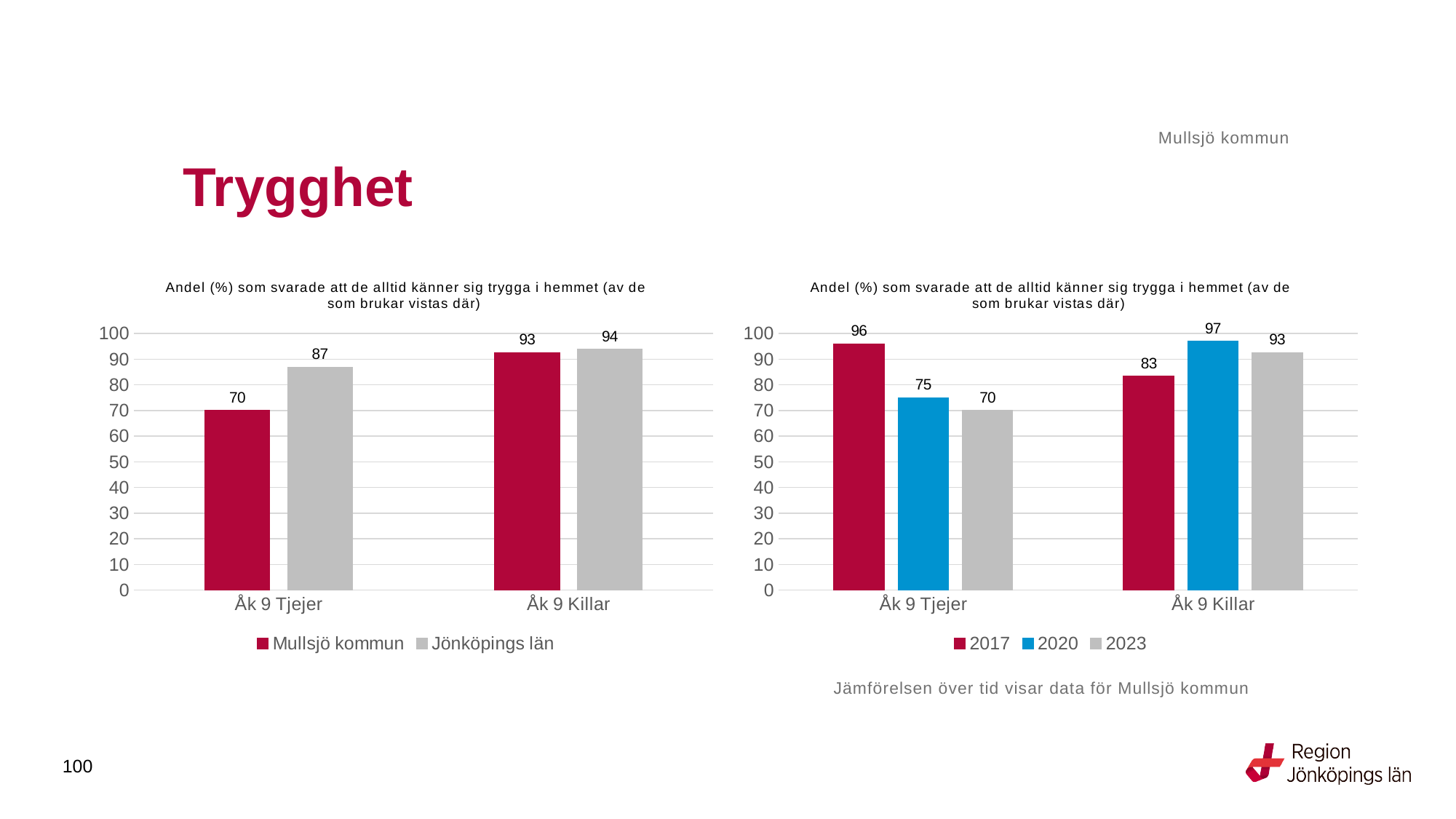
In the right chart, which year has the highest value for Åk 9 Killar? 2020 In the left chart, how many series does the legend list? 2 In the right chart, which year has the lowest value for Åk 9 Tjejer? 2023 In the right chart, is the value for 2020 for Åk 9 Tjejer larger or smaller than the value for 2020 for Åk 9 Killar? smaller In the right chart, what is the value for 2023 for Åk 9 Killar? 93 In the left chart, what is the difference between Jönköpings län and Mullsjö kommun for Åk 9 Tjejer? 17 In the right chart, what is the difference between 2017 and 2023 for Åk 9 Tjejer? 26 In the left chart, what is the value for Mullsjö kommun for Åk 9 Tjejer? 70 In the left chart, what is the value for Jönköpings län for Åk 9 Killar? 94 In the right chart, what is the value for 2017 for Åk 9 Tjejer? 96 What kind of chart is the right chart? bar chart In the right chart, how many series does the legend list? 3